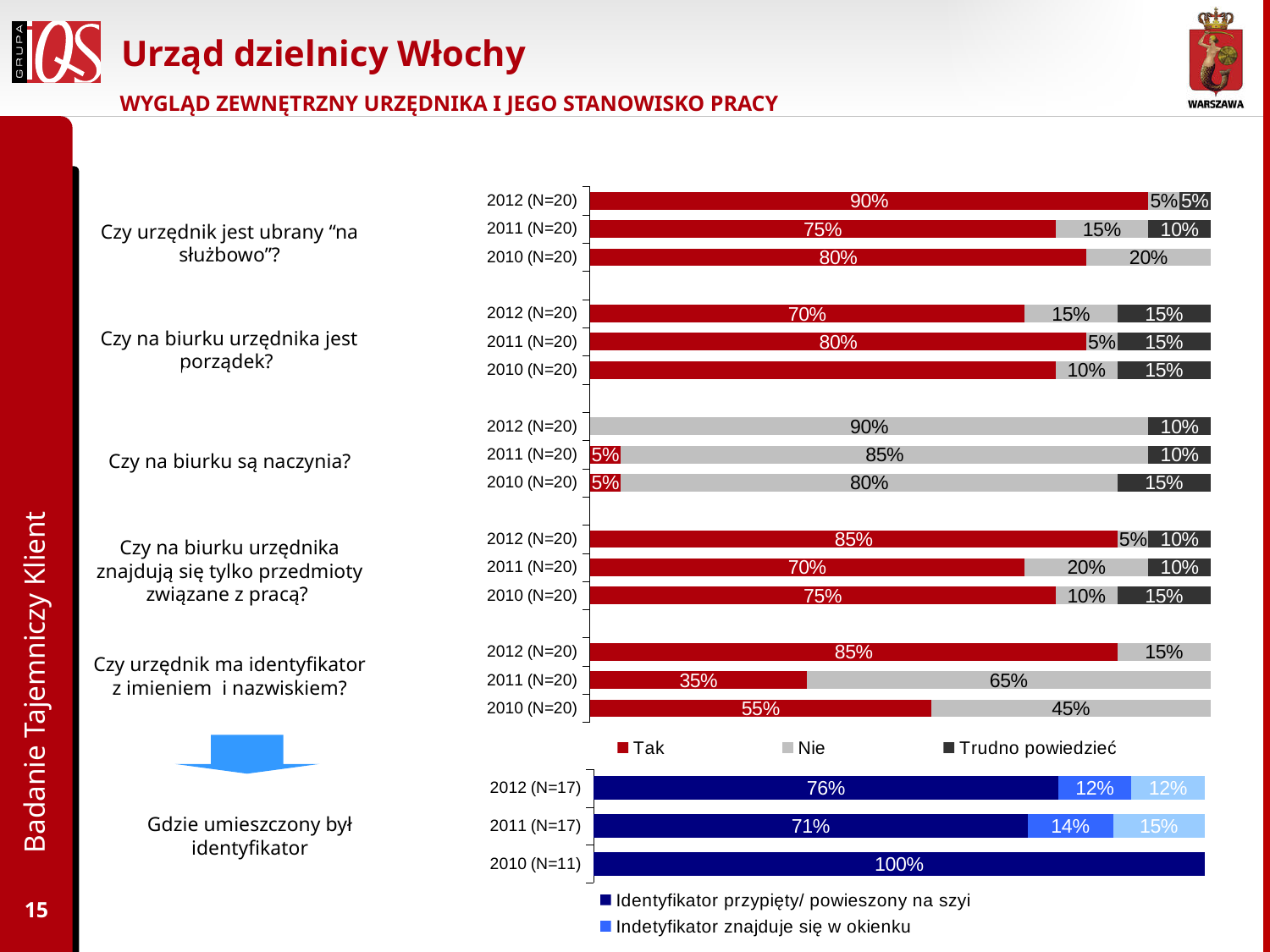
How many series does the legend of the upper chart list? 3 In the upper chart, for "Czy urzędnik ma identyfikator z imieniem i nazwiskiem?", which year has the highest "Tak" share? 2012 (N=20) In the lower chart ("Gdzie umieszczony był identyfikator"), what percentage is shown for "Indetyfikator znajduje się w okienku" in 2011 (N=17)? 14% In the upper chart, how does the "Tak" share for "Czy na biurku urzędnika znajdują się tylko przedmioty związane z pracą?" change from 2011 to 2012? It rises from 70% to 85% In the lower chart ("Gdzie umieszczony był identyfikator"), which year shows 100% for "Identyfikator przypięty/ powieszony na szyi"? 2010 (N=11) In the upper chart, what is the difference between the "Tak" shares for "Czy urzędnik jest ubrany 'na służbowo'?" in 2012 and 2011? 15% In the upper chart, for "Czy na biurku są naczynia?" in 2010 (N=20), which is larger: "Nie" or "Trudno powiedzieć"? Nie What type of chart is the upper chart? Stacked bar chart In the upper chart, for "Czy urzędnik ma identyfikator z imieniem i nazwiskiem?", which year has the lowest "Tak" share? 2011 (N=20) In the upper chart, what percentage answered "Nie" to "Czy urzędnik ma identyfikator z imieniem i nazwiskiem?" in 2011 (N=20)? 65% In the lower chart ("Gdzie umieszczony był identyfikator"), what percentage is shown for "Identyfikator przypięty/ powieszony na szyi" in 2012 (N=17)? 76% In the upper chart, what percentage answered "Tak" to "Czy urzędnik jest ubrany 'na służbowo'?" in 2012 (N=20)? 90%